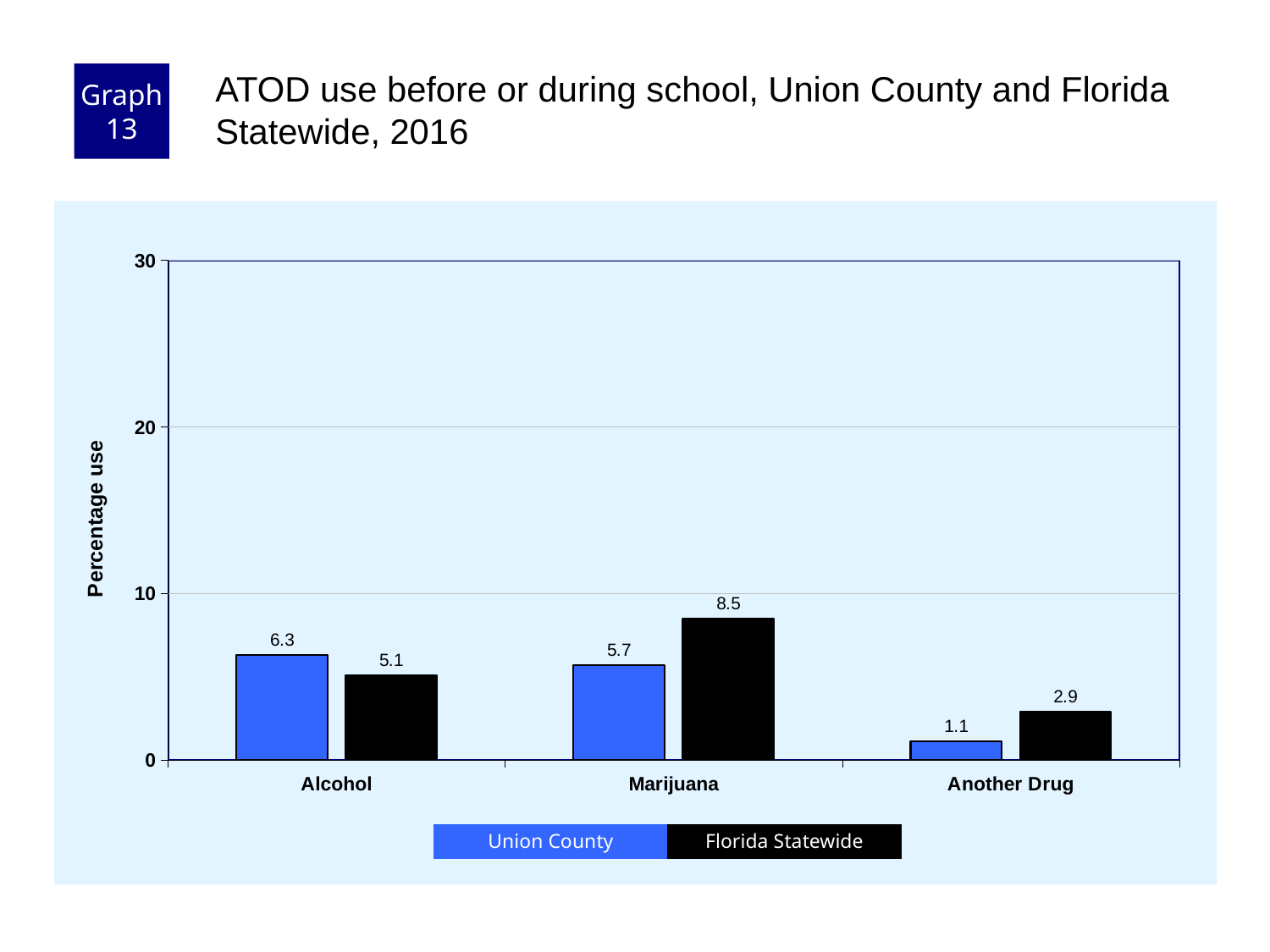
How many series does the legend list? 2 Is the Florida Statewide value for Marijuana greater or less than 10? less What kind of chart is shown on the slide? bar chart Which category has the highest Florida Statewide value? Marijuana For Alcohol, which is larger: Union County or Florida Statewide? Union County How many categories are shown on the x axis? 3 What is the Union County value for Another Drug? 1.1 What is the difference between the Florida Statewide and Union County values for Marijuana? 2.8 What is the Florida Statewide value for Alcohol? 5.1 What is the Union County value for Alcohol? 6.3 Which category has the lowest Union County value? Another Drug What is the Florida Statewide value for Marijuana? 8.5